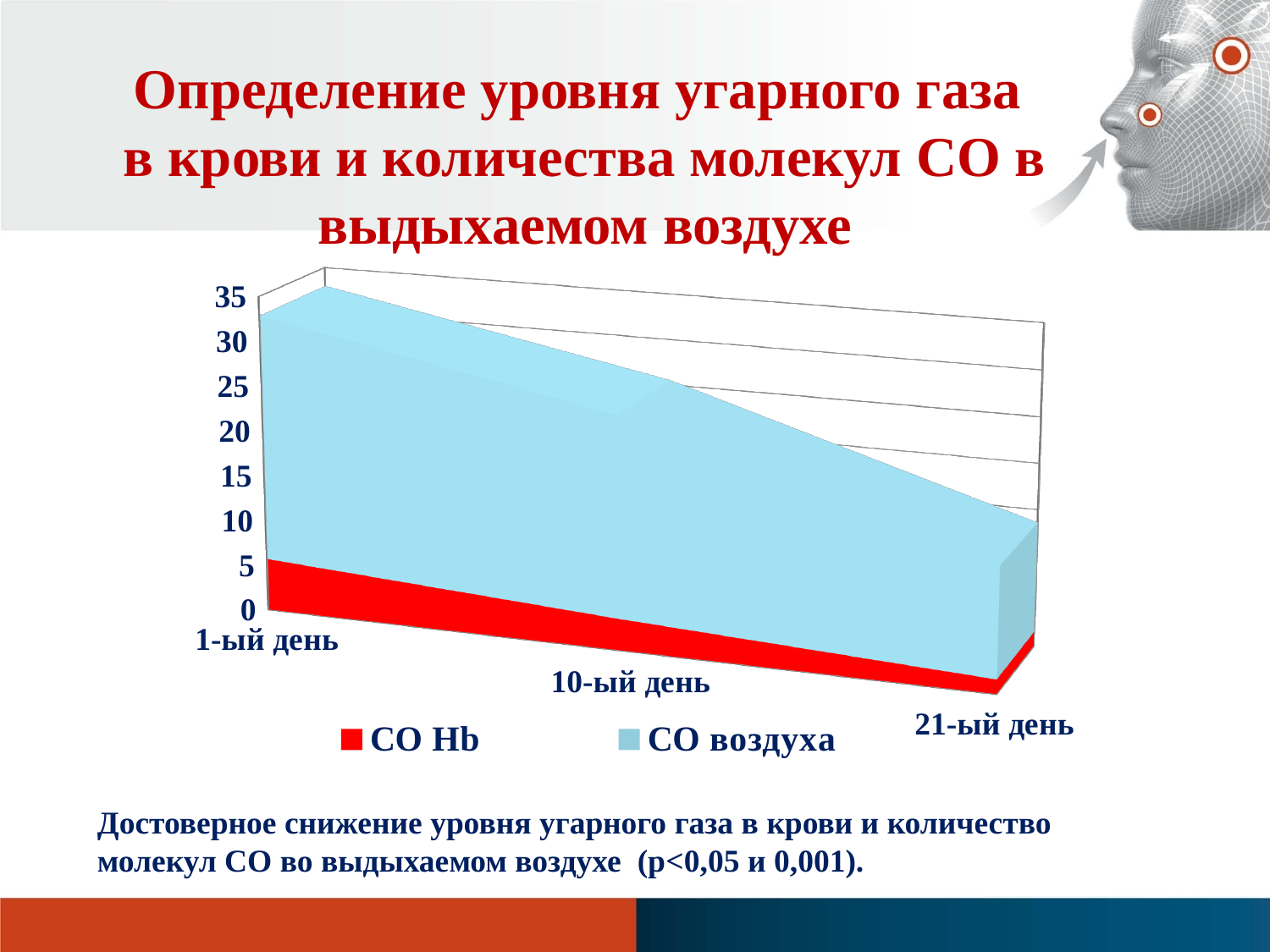
What are the two series named in the legend? CO Hb and CO воздуха How many categories (days) are shown on the x axis? 3 How many series does the legend list? 2 Is the value for CO Hb at 1-ый день greater or less than 10? less Which day has the lowest combined level of CO Hb and CO воздуха? 21-ый день What kind of chart is shown on the slide? area chart Is the combined value at 21-ый день greater or less than 20? less Do the values rise or fall from 1-ый день to 21-ый день? fall Is the combined value at 1-ый день greater or less than 25? greater Which colour represents the CO Hb series? red Which day has the highest combined level of CO Hb and CO воздуха? 1-ый день At 1-ый день, which series is larger, CO Hb or CO воздуха? CO воздуха